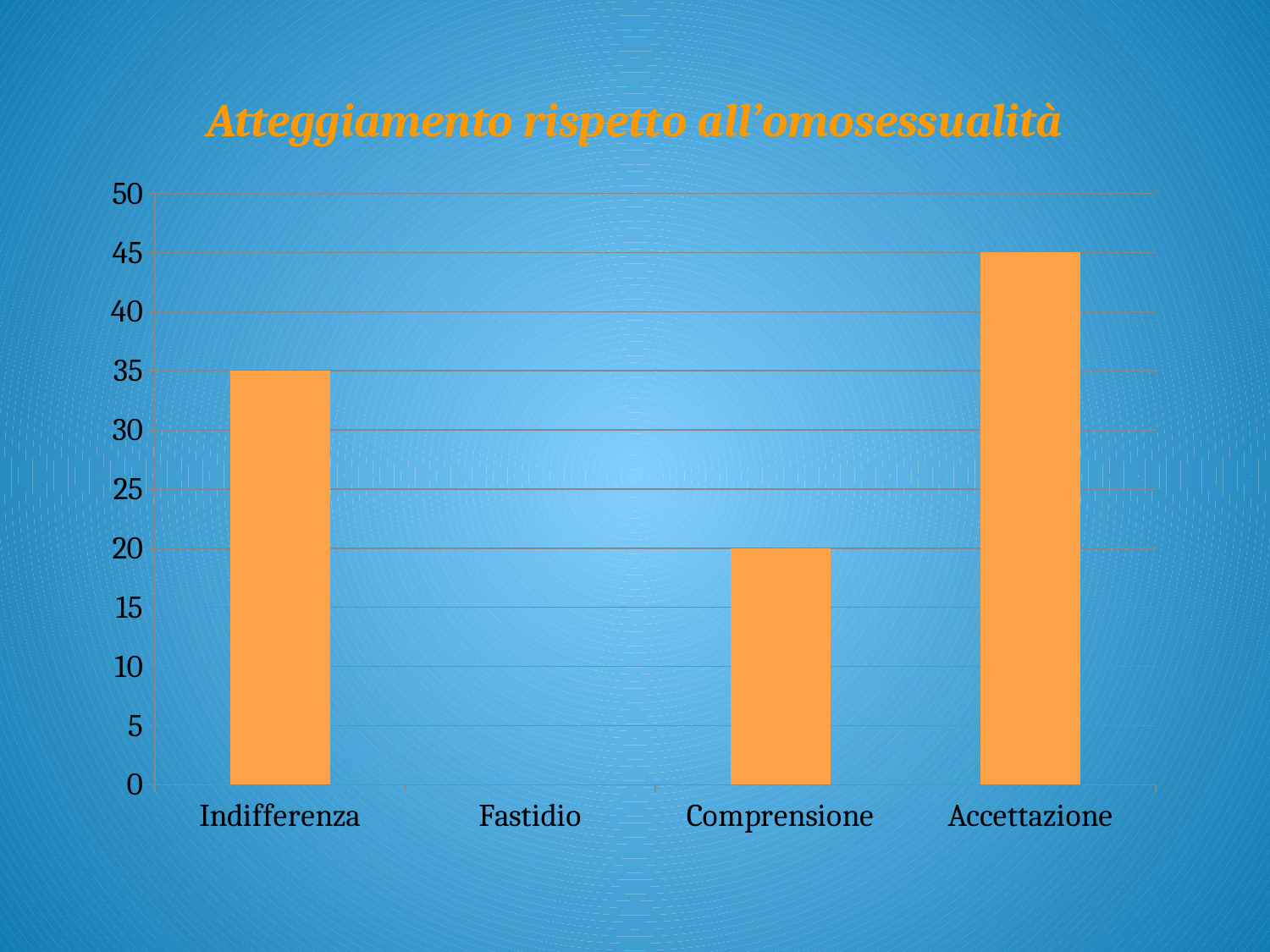
Which category has the lowest value? Fastidio What type of chart is shown on the slide? bar chart What is the difference between the values for Accettazione and Indifferenza? 10 What is the difference between the values for Indifferenza and Comprensione? 15 Which category has the highest value? Accettazione What is the value for Accettazione? 45 How many categories are shown on the x axis? 4 Which is larger, the value for Indifferenza or the value for Comprensione? Indifferenza What is the value for Comprensione? 20 Is the value for Accettazione greater or less than 40? greater What is the value for Indifferenza? 35 What is the title of the chart? Atteggiamento rispetto all'omosessualità